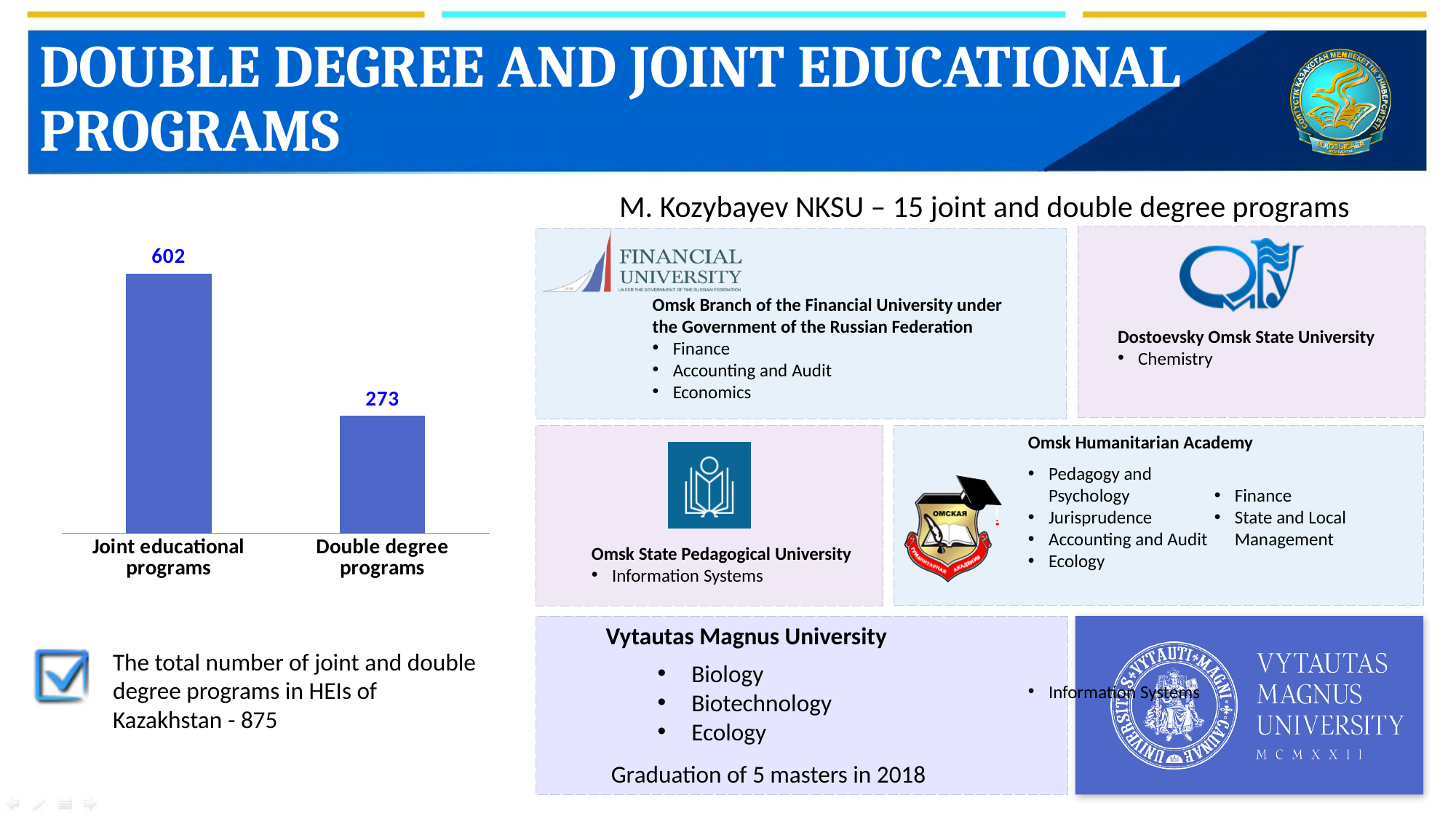
What is the value for Joint educational programs? 602 What is the total of the two values shown in the chart? 875 Do the values rise or fall from left to right across the categories? Fall Which category has the lowest value? Double degree programs What is the difference between the values for Joint educational programs and Double degree programs? 329 What is the value for Double degree programs? 273 What kind of chart is shown on the slide? Bar chart Which category has the highest value? Joint educational programs Which is larger, the value for Joint educational programs or the value for Double degree programs? Joint educational programs What colour are the bars in the chart? Blue How many categories are shown in the chart? 2